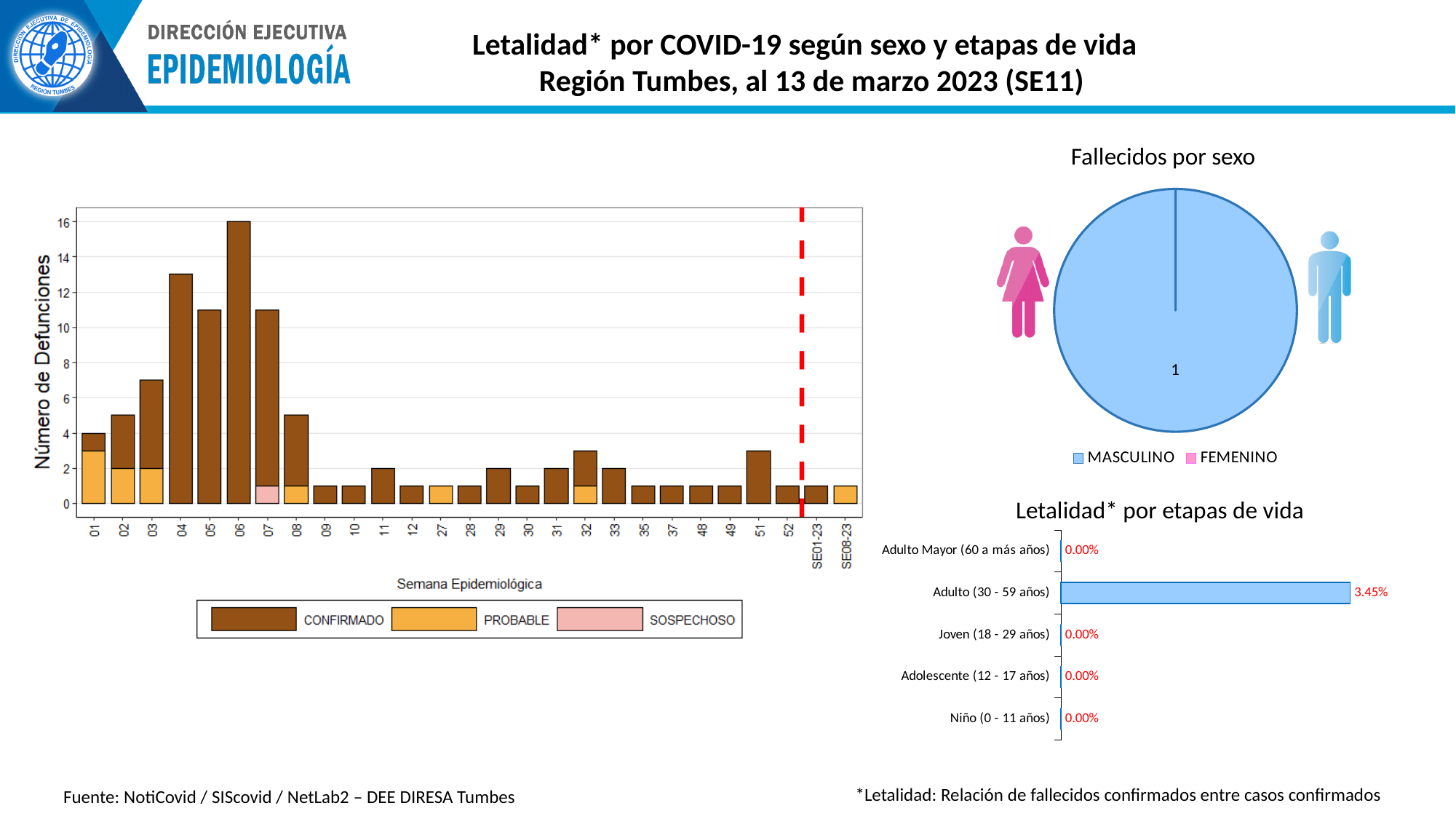
How many age-group categories are shown in the 'Letalidad* por etapas de vida' chart? 5 In the 'Número de Defunciones' bar chart on the left, what is the total height of the bar for week 06? 16 How many series does the legend of the 'Número de Defunciones' bar chart on the left list? 3 In the 'Fallecidos por sexo' pie chart, what value is printed on the slice? 1 In the 'Número de Defunciones' bar chart on the left, is the value for week 04 greater or less than 12? greater In the 'Fallecidos por sexo' pie chart, which category makes up the entire pie? MASCULINO In the 'Número de Defunciones' bar chart on the left, which epidemiological week has the highest number of deaths? 06 What kind of chart is 'Letalidad* por etapas de vida'? Bar chart In the 'Letalidad* por etapas de vida' chart, which age group has the highest value? Adulto (30 - 59 años) In the 'Fallecidos por sexo' chart, how many series does the legend list? 2 In the 'Letalidad* por etapas de vida' chart, what is the value for Adulto (30 - 59 años)? 3.45% In the 'Letalidad* por etapas de vida' chart, what is the value for Adulto Mayor (60 a más años)? 0.00%